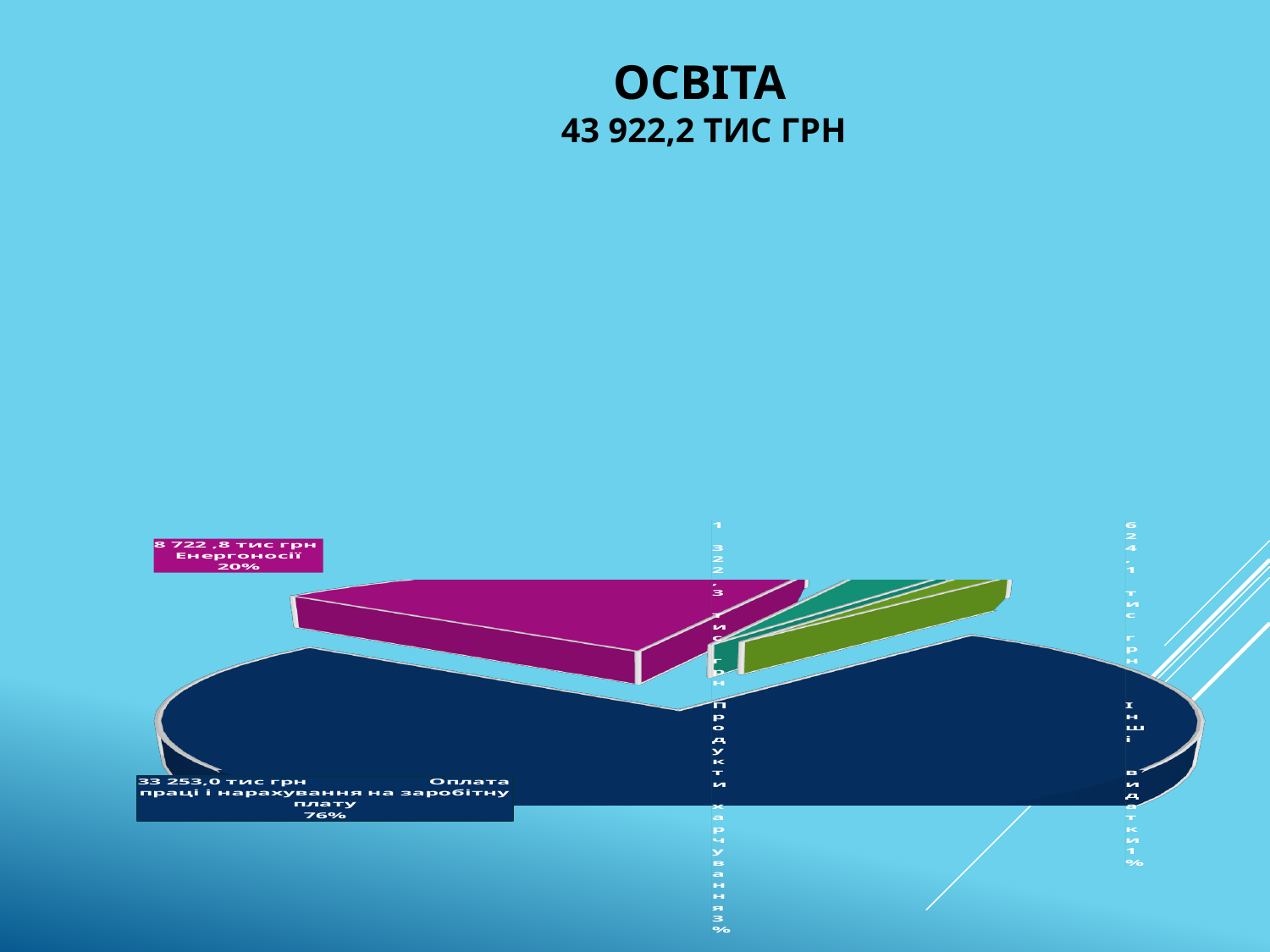
Which is larger, the value for Енергоносії or the value for Продукти харчування? Енергоносії What is the value for Оплата праці і нарахування на заробітну плату? 33 253,0 тис грн How many slices does the pie chart have? 4 Which category has the largest slice of the pie? Оплата праці і нарахування на заробітну плату What total amount is stated in the slide title under ОСВІТА? 43 922,2 тис грн Which category has the smallest slice of the pie? Інші видатки What is the difference between the percentage shares of Оплата праці і нарахування на заробітну плату and Енергоносії? 56% What is the value for Енергоносії? 8 722,8 тис грн What share of the pie does Продукти харчування represent? 3% What share of the pie does Оплата праці і нарахування на заробітну плату represent? 76% What kind of chart is shown on the slide? pie chart What share of the pie does Енергоносії represent? 20%